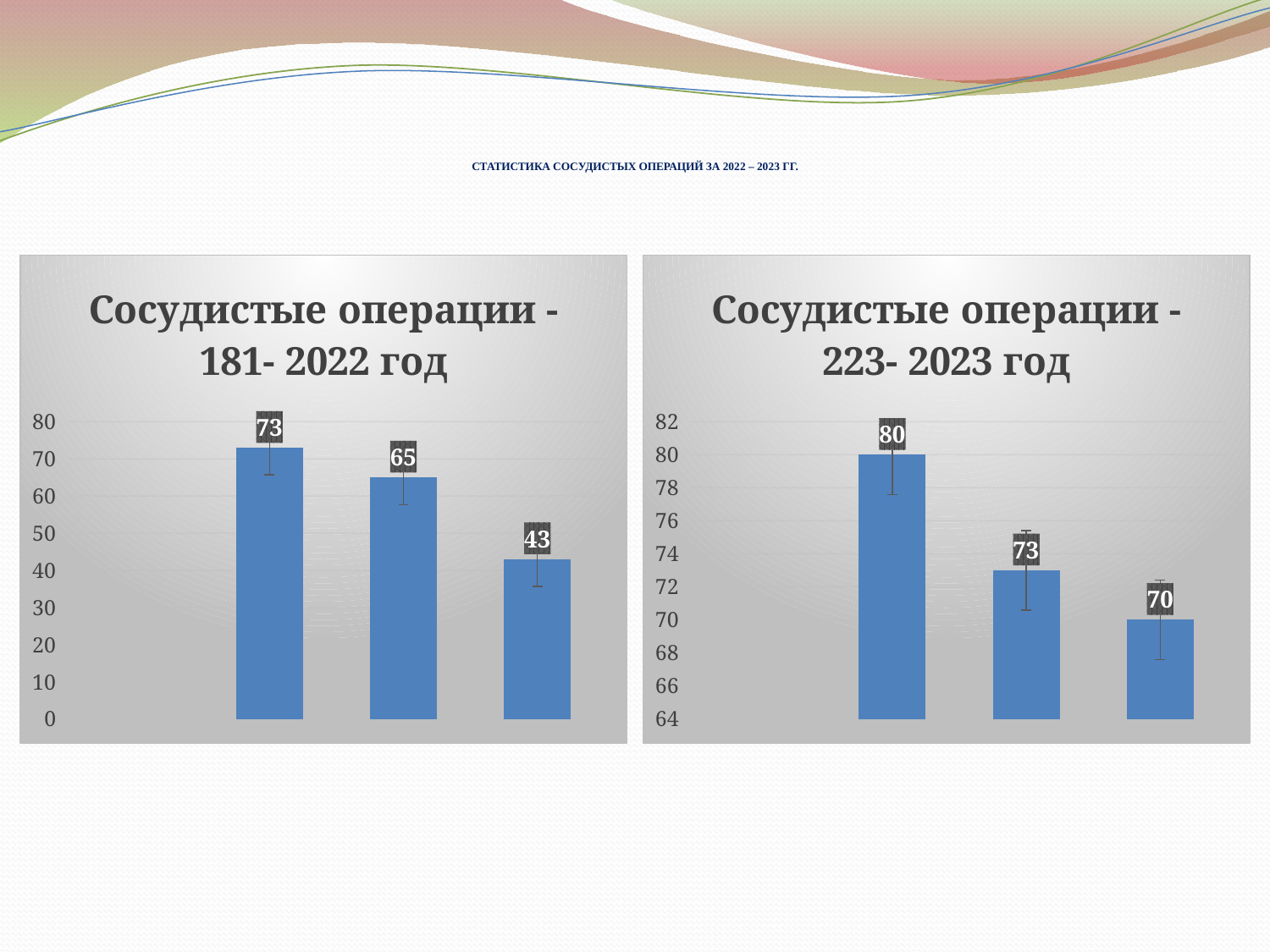
In the right chart (2023 год), what is the highest value shown? 80 In the left chart (2022 год), what is the value of the middle bar? 65 In the right chart (2023 год), what is the value of the first (leftmost) bar? 80 In the right chart (2023 год), what is the value of the third (rightmost) bar? 70 What type of chart is the left chart titled 'Сосудистые операции - 181- 2022 год'? bar chart In the left chart (2022 год), what is the value of the third (rightmost) bar? 43 In the left chart (2022 год), do the values rise or fall from left to right? fall In the left chart (2022 год), what is the lowest value shown? 43 In the left chart (2022 год), what is the difference between the first bar and the third bar? 30 In the right chart (2023 год), what is the difference between the first bar and the second bar? 7 In the left chart (2022 год), what is the value of the first (leftmost) bar? 73 How many bars are plotted in the right chart (2023 год)? 3